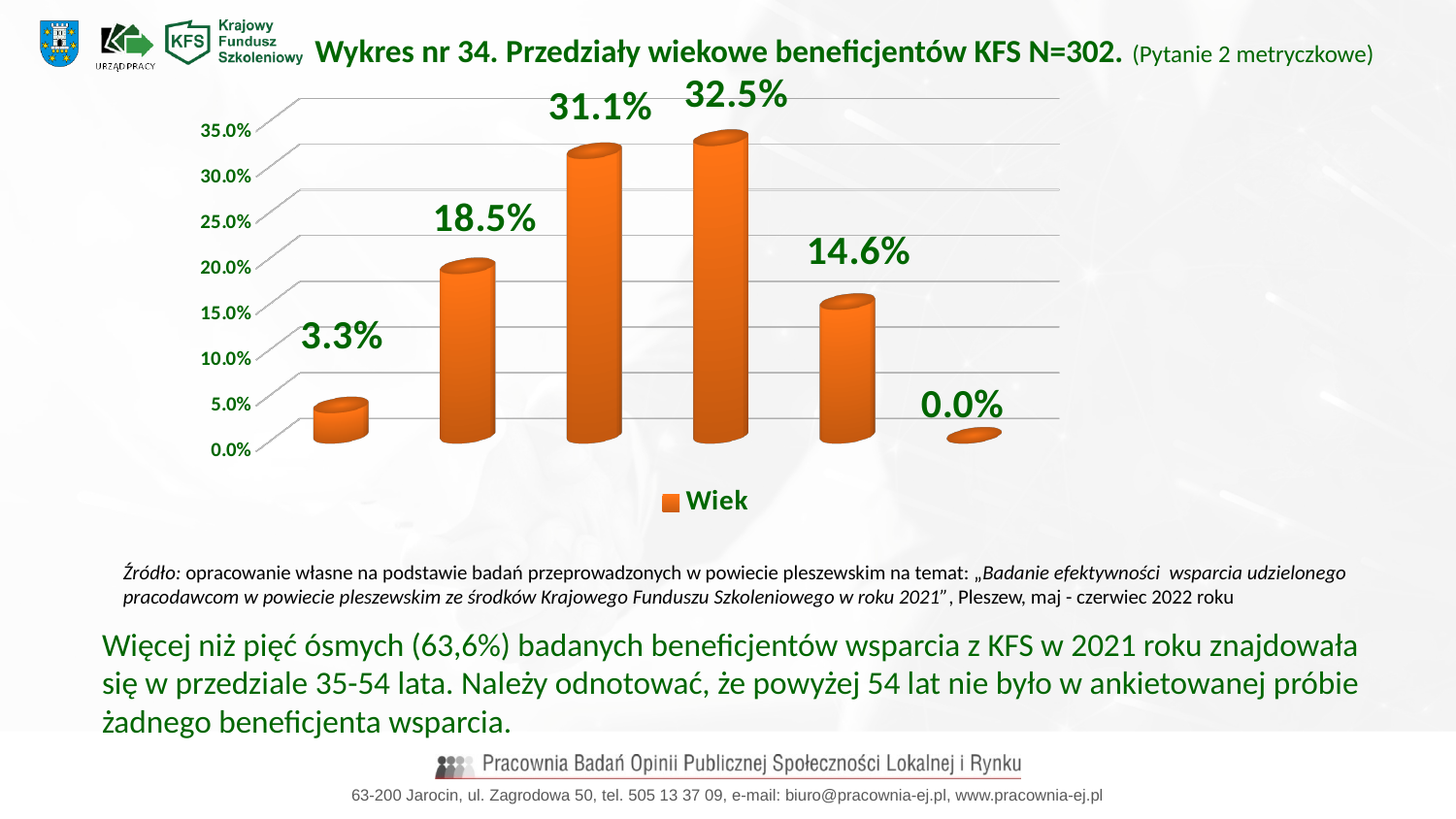
What type of chart is shown on the slide? bar chart How many series does the legend list? 1 What is the value of the last (rightmost) bar? 0.0% What is the name of the series shown in the legend? Wiek Which is larger, the second bar or the fifth bar? the second bar (18.5%) What is the value of the fourth bar from the left? 32.5% What is the value of the first (leftmost) bar? 3.3% What is the lowest value shown in the chart? 0.0% What is the value of the second bar from the left? 18.5% What is the difference between the third bar (31.1%) and the fifth bar (14.6%)? 16.5% How many bars are plotted in the chart? 6 What is the highest value shown in the chart? 32.5%